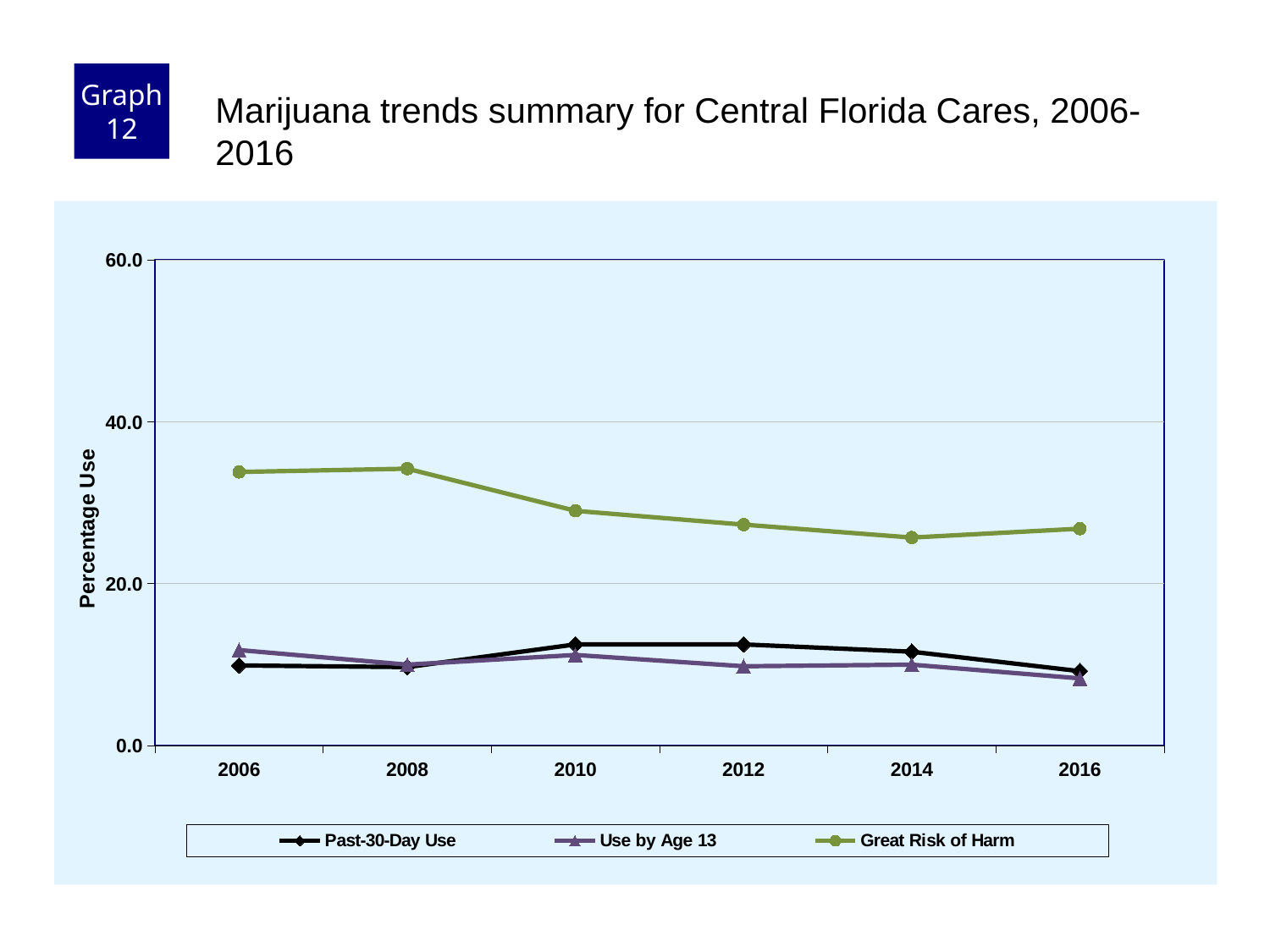
Is the value for Great Risk of Harm in 2014 greater or less than 20.0? greater How many years are plotted along the x axis? 6 Is the value for Past-30-Day Use in 2012 greater or less than 20.0? less In which year is the Use by Age 13 series at its lowest? 2016 What is the label on the y axis? Percentage Use Which series is drawn with a green line and circle markers? Great Risk of Harm How many series does the legend list? 3 Which series has the highest value in 2010? Great Risk of Harm What kind of chart is shown on the slide? line chart Is the value for Great Risk of Harm in 2006 greater or less than 40.0? less Does the Great Risk of Harm series rise or fall overall from 2006 to 2016? fall In 2016, which is larger: Past-30-Day Use or Use by Age 13? Past-30-Day Use